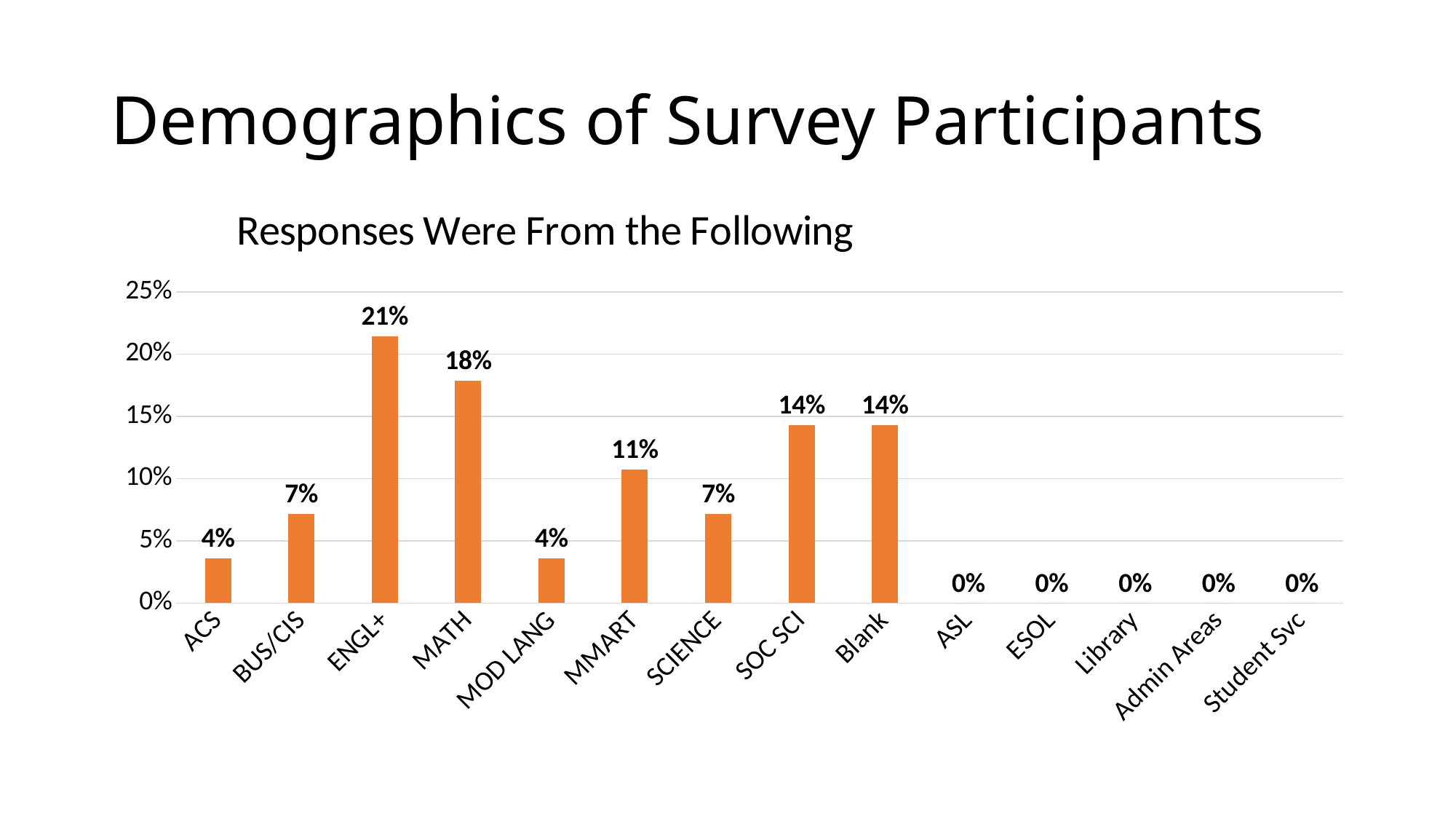
What is the value for MMART? 11% What is the difference between the values for ENGL+ and MATH? 3% What is the value for ENGL+? 21% Which is larger, the value for BUS/CIS or the value for MMART? MMART What kind of chart is shown on the slide? Bar chart What is the title of the chart? Responses Were From the Following How many categories have a value of 0%? 5 Which category has the highest value? ENGL+ What is the value for SOC SCI? 14% What is the difference between the values for SOC SCI and ACS? 10% How many categories are shown on the x axis? 14 Which is larger, the value for MATH or the value for Blank? MATH